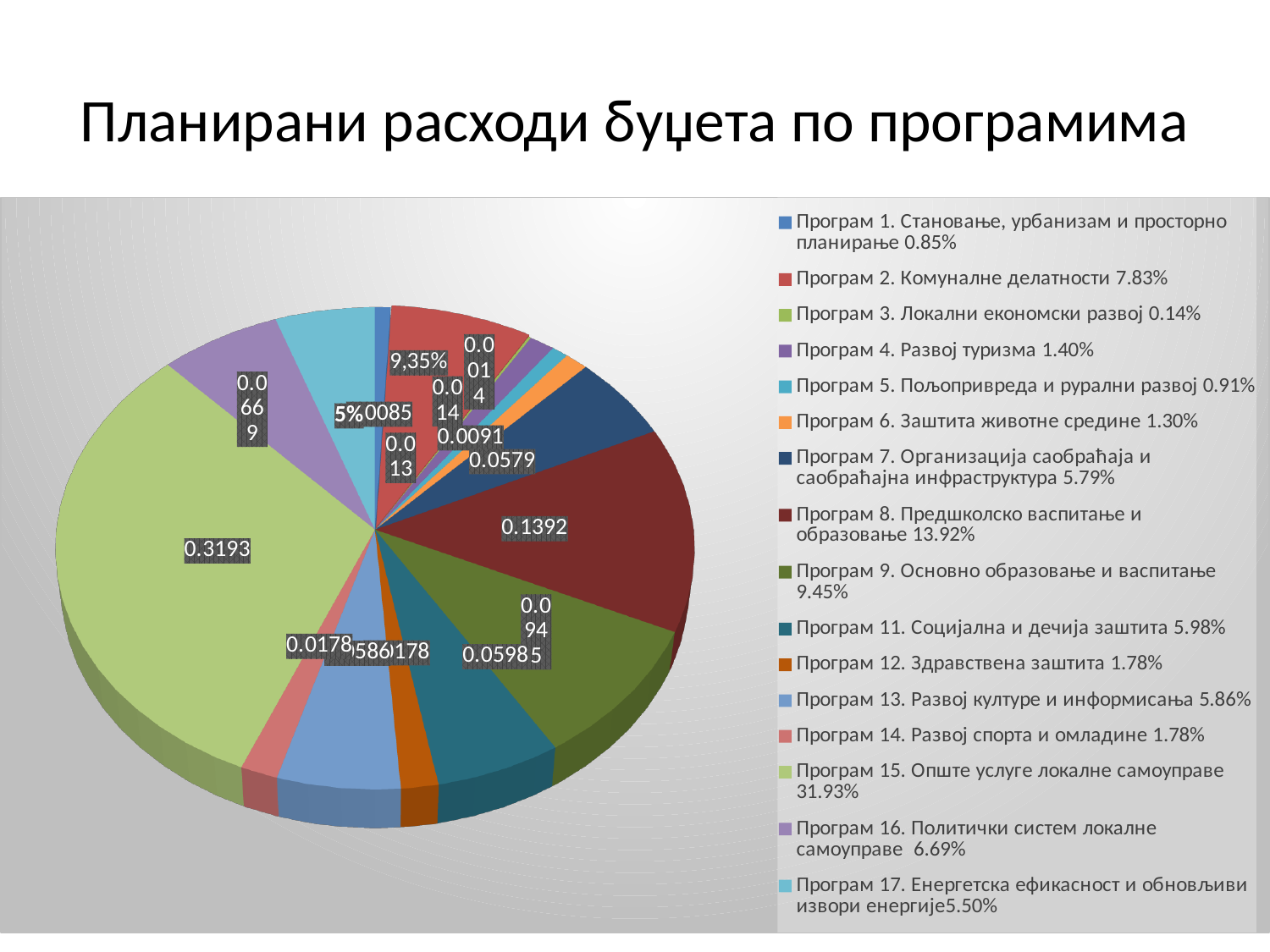
What kind of chart is shown on the slide? pie chart What share of the budget is planned for Програм 17. Енергетска ефикасност и обновљиви извори енергије? 5.50% Which program has the smallest share of the planned budget expenditure? Програм 3. Локални економски развој (0.14%) What is the title of the chart? Планирани расходи буџета по програмима Which program has the largest share of the planned budget expenditure? Програм 15. Опште услуге локалне самоуправе (31.93%) What is the difference in percentage points between Програм 8. Предшколско васпитање и образовање (13.92%) and Програм 9. Основно образовање и васпитање (9.45%)? 4.47 percentage points Which two programs in the legend have the same share of 1.78%? Програм 12. Здравствена заштита and Програм 14. Развој спорта и омладине What data label is shown on the largest slice of the pie? 0.3193 What share of the budget is planned for Програм 8. Предшколско васпитање и образовање? 13.92% Which has a larger share: Програм 2. Комуналне делатности or Програм 16. Политички систем локалне самоуправе? Програм 2. Комуналне делатности How many programs does the legend list? 16 What share of the budget is planned for Програм 2. Комуналне делатности? 7.83%